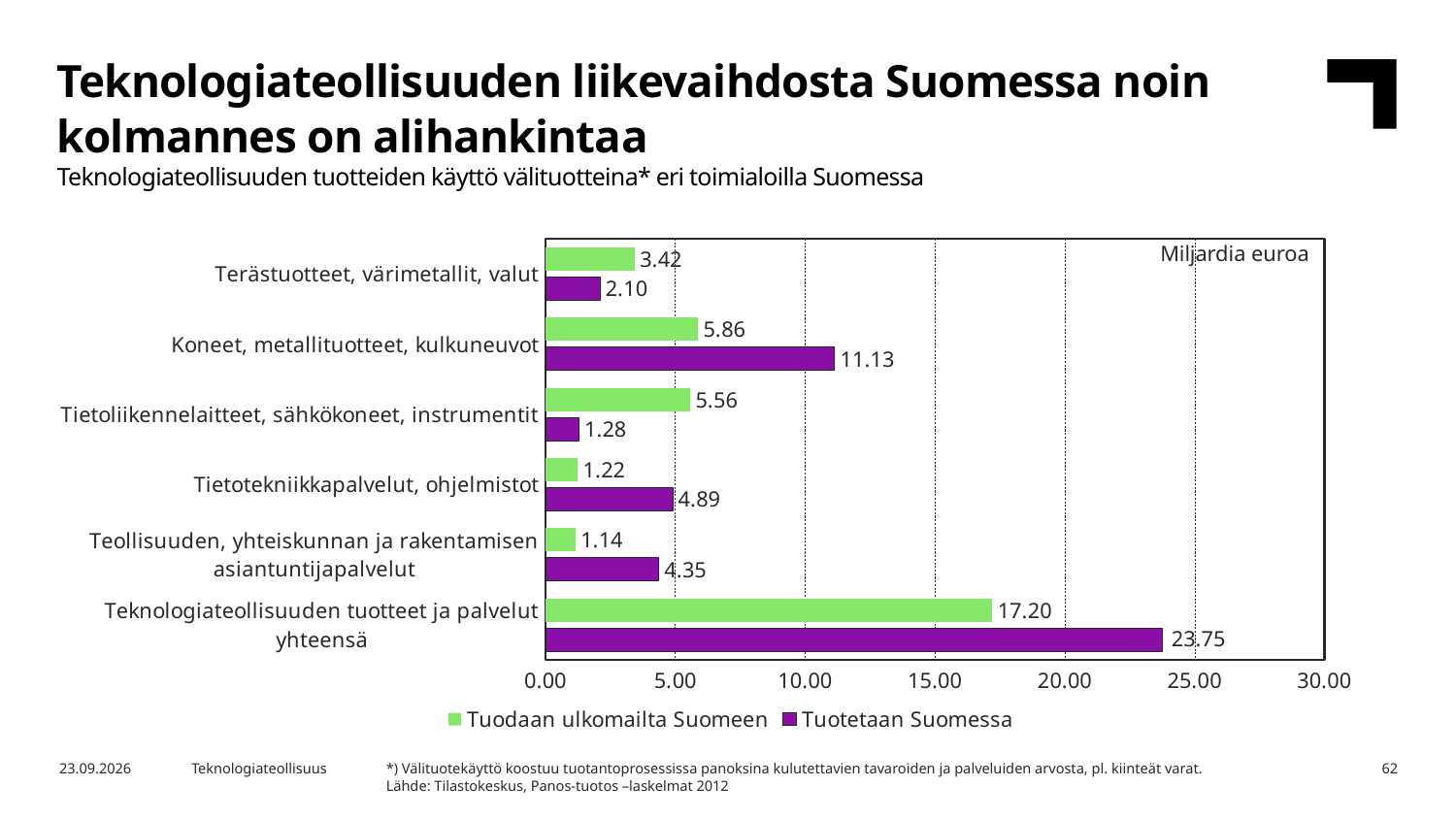
What unit is indicated in the top right corner of the chart? Miljardia euroa What is the value of 'Tuotetaan Suomessa' for 'Teknologiateollisuuden tuotteet ja palvelut yhteensä'? 23.75 How many series does the legend list? 2 How many categories are shown on the chart? 6 For 'Terästuotteet, värimetallit, valut', which is larger: 'Tuodaan ulkomailta Suomeen' or 'Tuotetaan Suomessa'? Tuodaan ulkomailta Suomeen Excluding the total row, which category has the highest value for 'Tuotetaan Suomessa'? Koneet, metallituotteet, kulkuneuvot What kind of chart is shown on the slide? Bar chart What is the value of 'Tuodaan ulkomailta Suomeen' for 'Tietoliikennelaitteet, sähkökoneet, instrumentit'? 5.56 What is the difference between 'Tuotetaan Suomessa' and 'Tuodaan ulkomailta Suomeen' for 'Teknologiateollisuuden tuotteet ja palvelut yhteensä'? 6.55 Which category has the lowest value for 'Tuodaan ulkomailta Suomeen'? Teollisuuden, yhteiskunnan ja rakentamisen asiantuntijapalvelut What is the value of 'Tuotetaan Suomessa' for 'Koneet, metallituotteet, kulkuneuvot'? 11.13 Is the value of 'Tuotetaan Suomessa' for 'Tietotekniikkapalvelut, ohjelmistot' greater or less than 5.00? less